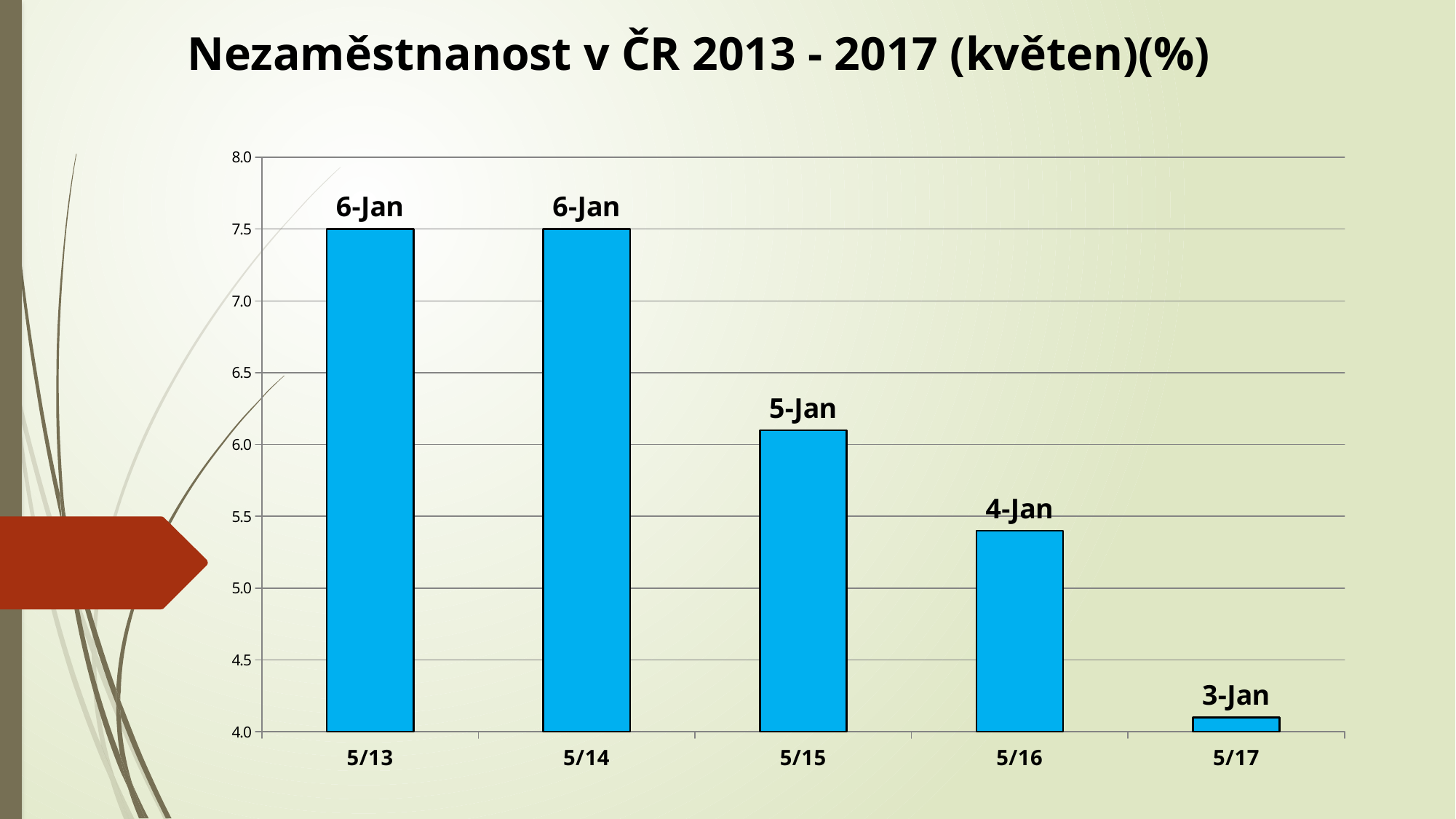
Is the value for 5/17 greater or less than 4.5? less What is the value for 5/13? 7.5 How many bars (categories) are plotted in the chart? 5 What type of chart is shown on the slide? bar chart Is the value for 5/16 greater or less than 5.5? less Which is larger, the value for 5/15 or the value for 5/16? 5/15 Which category has the lowest value? 5/17 Is the value for 5/15 greater or less than 6.0? greater What is the title of the chart? Nezaměstnanost v ČR 2013 - 2017 (květen)(%) Do the values rise or fall from 5/13 to 5/17? fall What data label is printed above the bar for 5/17? 3-Jan What is the value for 5/14? 7.5